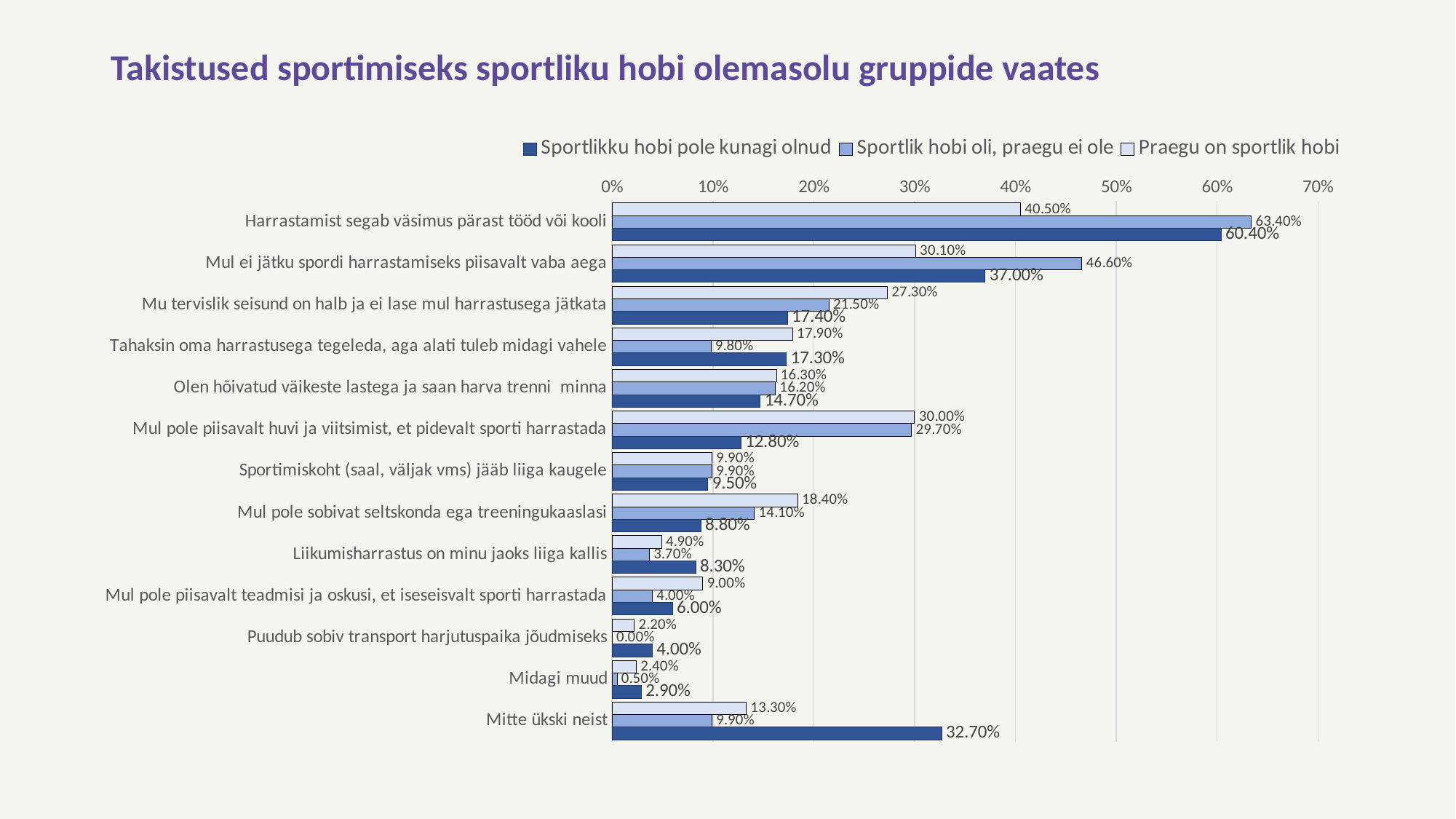
What is the difference between the "Sportlik hobi oli, praegu ei ole" and "Sportlikku hobi pole kunagi olnud" values for "Mul ei jätku spordi harrastamiseks piisavalt vaba aega"? 9.60% How many series does the legend list? 3 What is the value for "Harrastamist segab väsimus pärast tööd või kooli" in the "Sportlik hobi oli, praegu ei ole" series? 63.40% What is the title of the chart? Takistused sportimiseks sportliku hobi olemasolu gruppide vaates Which category has the highest value in the "Sportlikku hobi pole kunagi olnud" series? Harrastamist segab väsimus pärast tööd või kooli Is the value for "Mitte ükski neist" in the "Sportlikku hobi pole kunagi olnud" series greater or less than 30%? greater Which category has the lowest value in the "Sportlik hobi oli, praegu ei ole" series? Puudub sobiv transport harjutuspaika jõudmiseks For "Liikumisharrastus on minu jaoks liiga kallis", which series has the larger value: "Sportlikku hobi pole kunagi olnud" or "Praegu on sportlik hobi"? Sportlikku hobi pole kunagi olnud What type of chart is shown on the slide? bar chart What is the value for "Mul ei jätku spordi harrastamiseks piisavalt vaba aega" in the "Praegu on sportlik hobi" series? 30.10% What is the value for "Mitte ükski neist" in the "Sportlikku hobi pole kunagi olnud" series? 32.70% How many categories (obstacles) are shown on the chart? 13